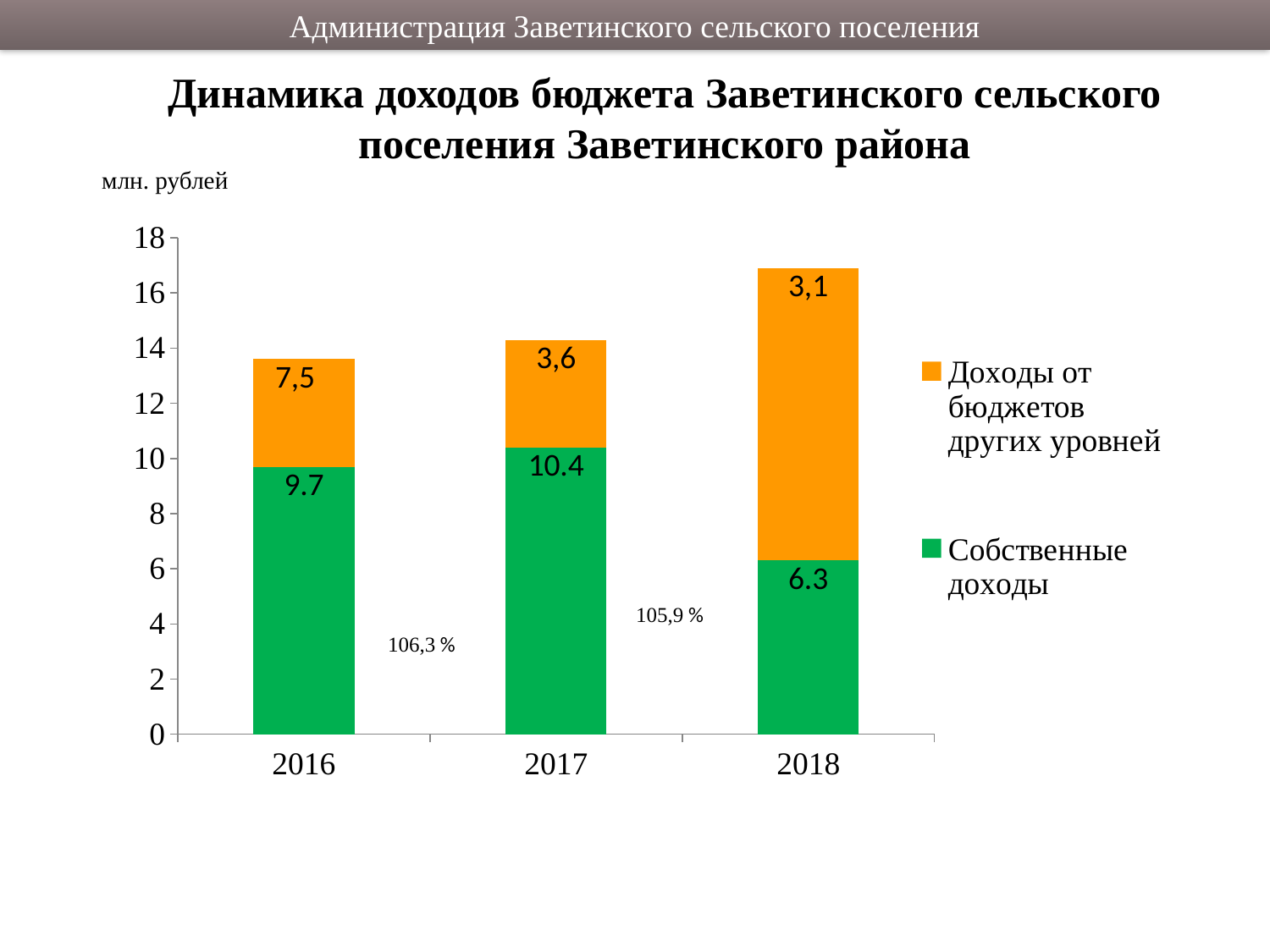
Is the value of Собственные доходы for 2018 greater or less than 8? less What is the difference between Собственные доходы in 2017 and 2016? 0.7 What is the value of Собственные доходы for 2017? 10.4 In which year is Собственные доходы highest? 2017 How many series does the legend list? 2 In which year is Собственные доходы lowest? 2018 What is the value of Собственные доходы for 2018? 6.3 How many years are shown on the x axis? 3 What kind of chart is shown on the slide? stacked bar chart Which is larger, Собственные доходы in 2016 or in 2017? 2017